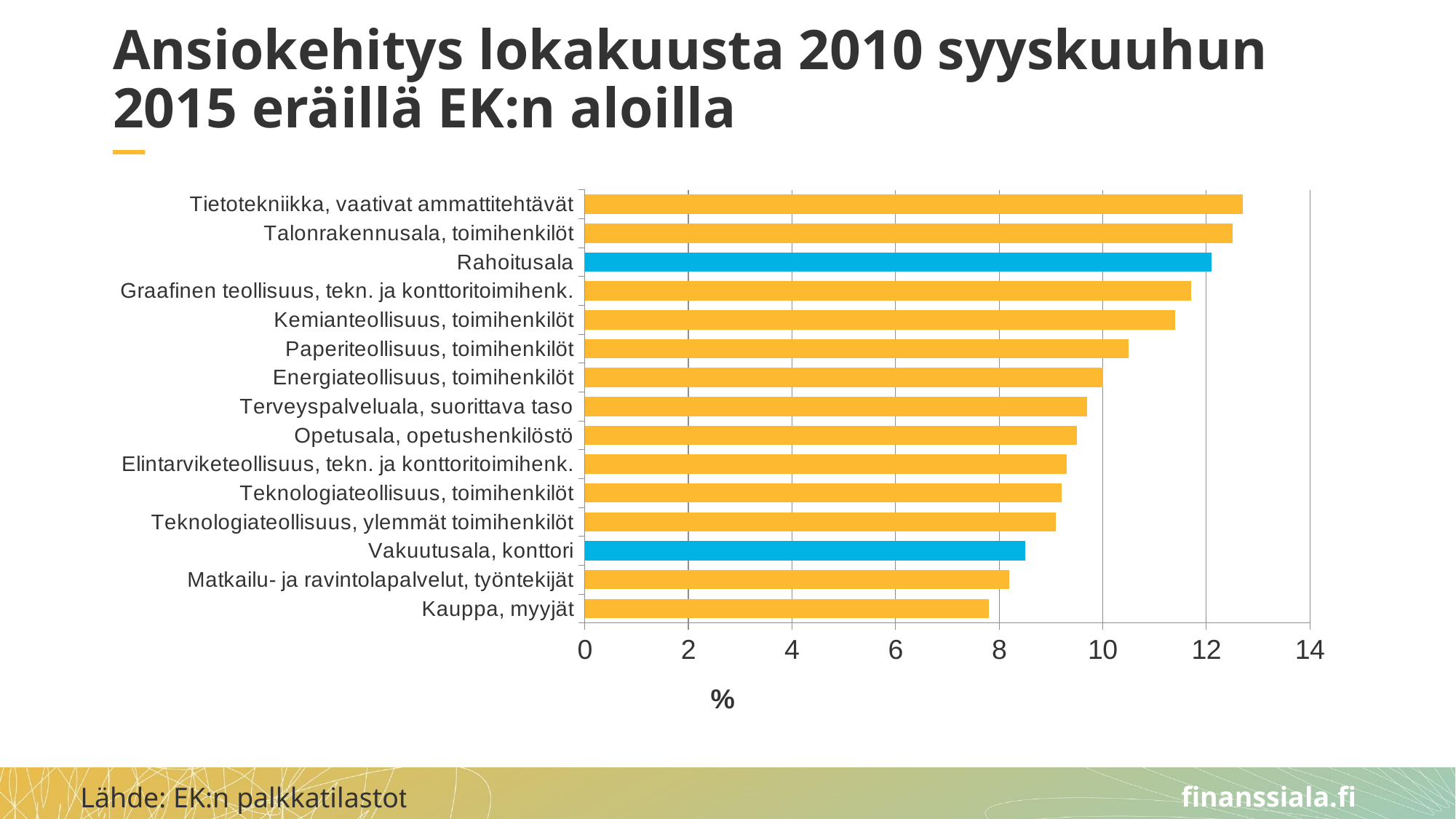
What kind of chart is shown on the slide? bar chart How many categories (industries) are plotted in the chart? 15 Which has the larger value, Kemianteollisuus, toimihenkilöt or Paperiteollisuus, toimihenkilöt? Kemianteollisuus, toimihenkilöt Is the value for Vakuutusala, konttori greater or less than 8? greater What is the label on the horizontal axis of the chart? % Is the value for Terveyspalveluala, suorittava taso greater or less than 10? less Which category has the lowest value in the chart? Kauppa, myyjät Is the value for Tietotekniikka, vaativat ammattitehtävät greater or less than 12? greater Which has the larger value, Rahoitusala or Vakuutusala, konttori? Rahoitusala Which two categories are shown with blue bars instead of orange? Rahoitusala and Vakuutusala, konttori